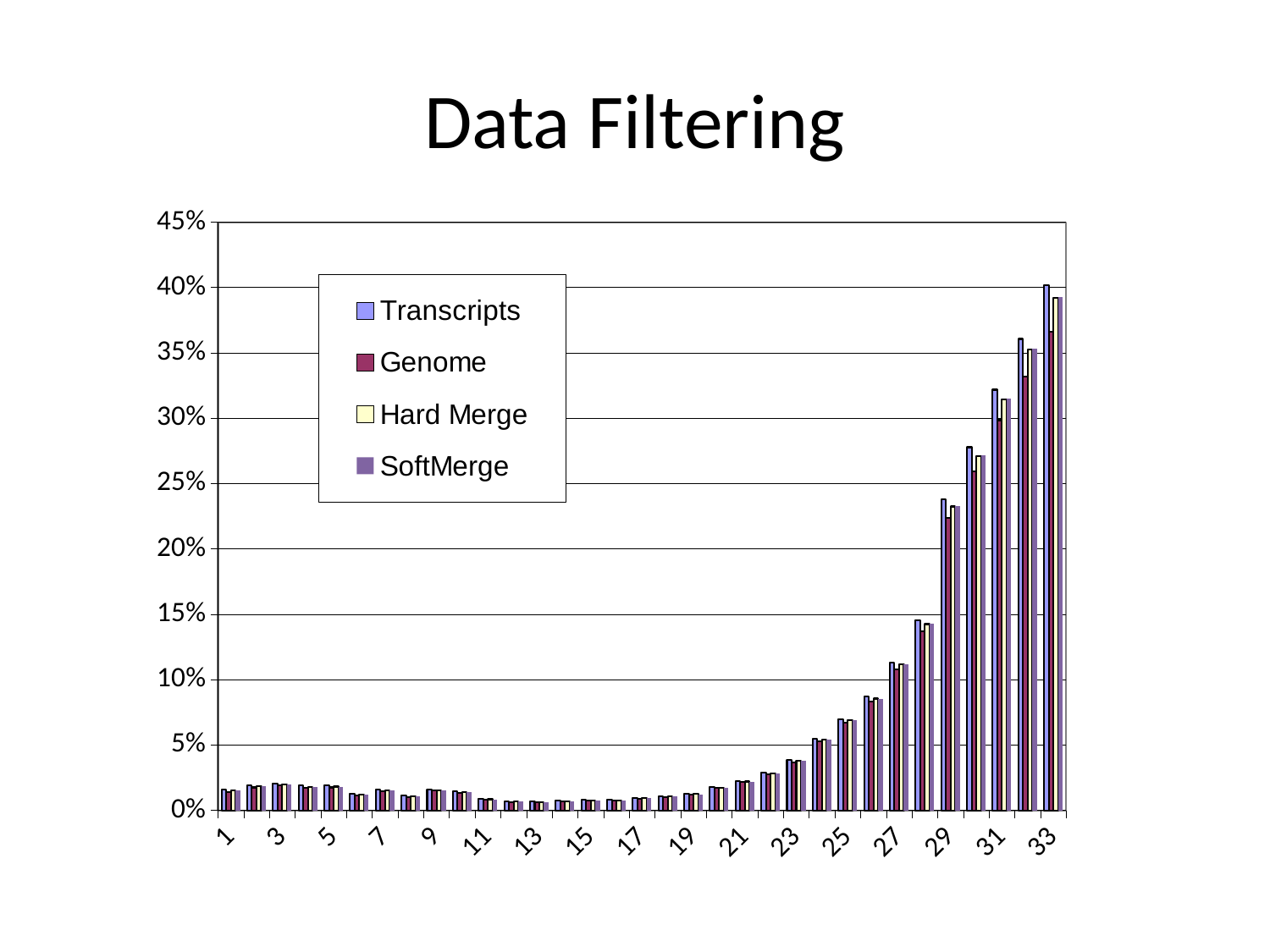
For category 33, which is larger: the Transcripts value or the Genome value? Transcripts Is the Transcripts value for category 33 greater or less than 35%? greater Which category has the highest value for the Transcripts series? 33 How many categories are shown along the x axis? 33 What kind of chart is shown on the slide? bar chart Is the Transcripts value for category 25 greater or less than 10%? less How many series does the legend list? 4 Is the Transcripts value for category 29 greater or less than 20%? greater Which series are listed in the legend? Transcripts, Genome, Hard Merge, SoftMerge What is the title of the chart? Data Filtering Do the values generally rise or fall from category 21 to category 33? rise